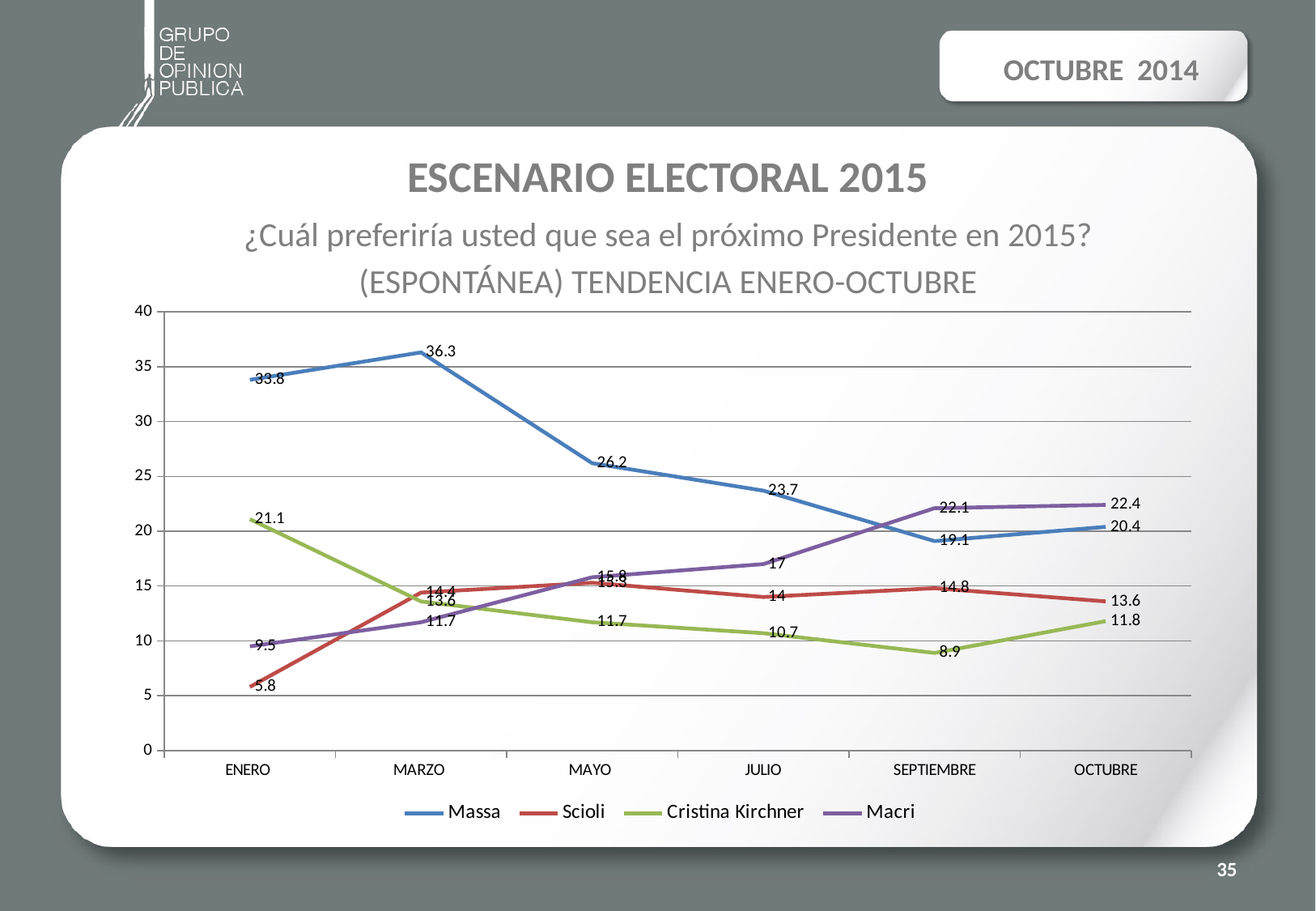
What colour is the line for Macri? purple What kind of chart is shown on the slide? line chart In OCTUBRE, which is larger: the value for Macri or the value for Massa? Macri What is the value for Scioli in ENERO? 5.8 How many months are shown on the x axis? 6 What is the value for Massa in ENERO? 33.8 In which month does Cristina Kirchner have the lowest value? SEPTIEMBRE How many series does the legend list? 4 In which month does Massa reach the highest value? MARZO Does the value for Massa rise or fall from MARZO to SEPTIEMBRE? fall What is the difference between Massa's value in MARZO and in OCTUBRE? 15.9 What is the value for Macri in OCTUBRE? 22.4